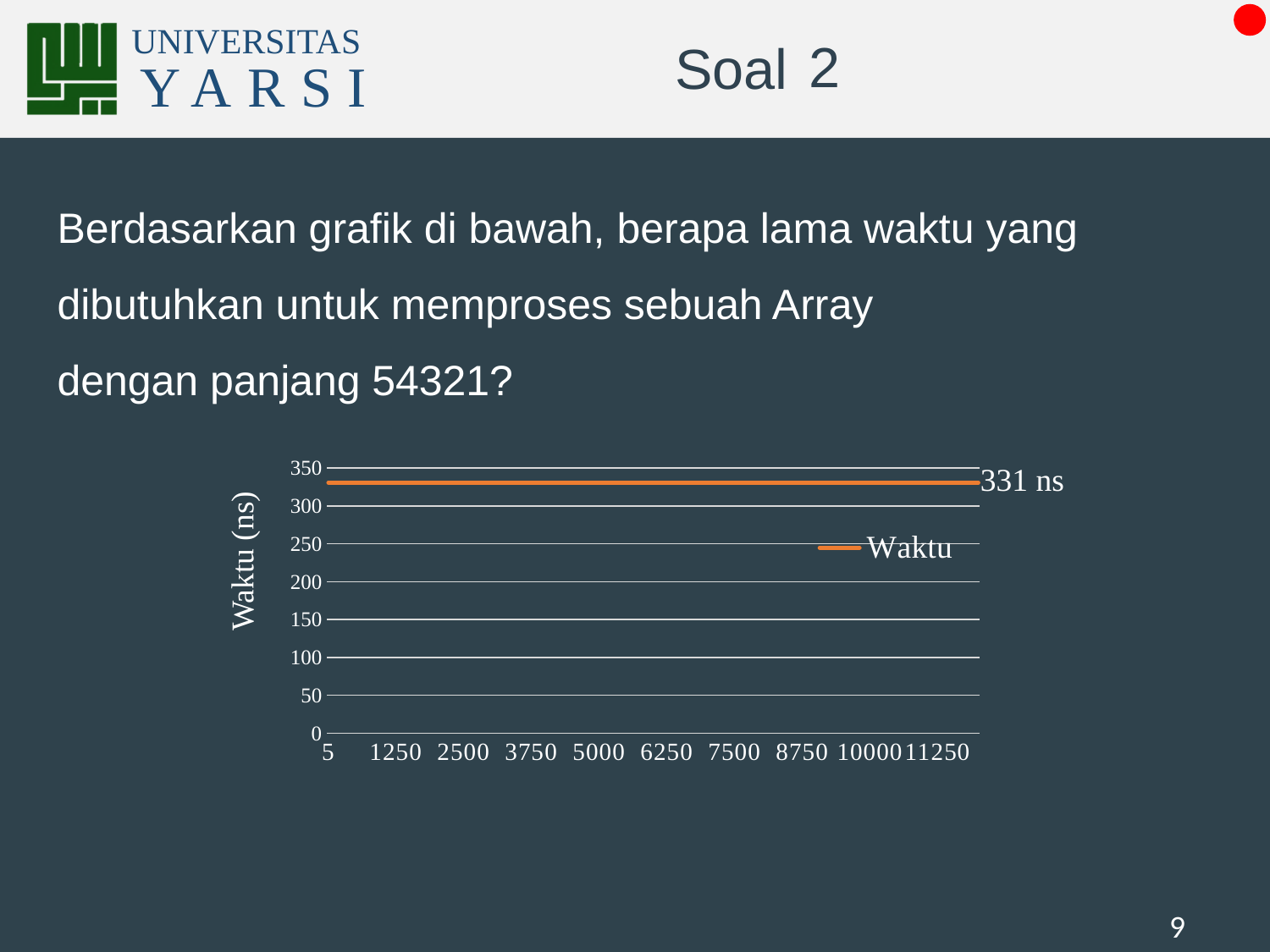
Is the value of the Waktu line greater or less than 350? less What is the name of the series shown in the chart's legend? Waktu What is the label on the chart's vertical axis? Waktu (ns) According to the chart, what is the value of Waktu at an array length of 5000? 331 ns Does the Waktu line rise, fall, or stay flat as the x-axis values increase? stays flat What is the highest tick value shown on the chart's vertical axis? 350 How many series does the chart's legend list? 1 What kind of chart is shown on the slide? line chart How many tick labels are shown on the chart's horizontal axis? 10 What value is printed as the data label on the line in the chart? 331 ns Is the value of the Waktu line greater or less than 300? greater